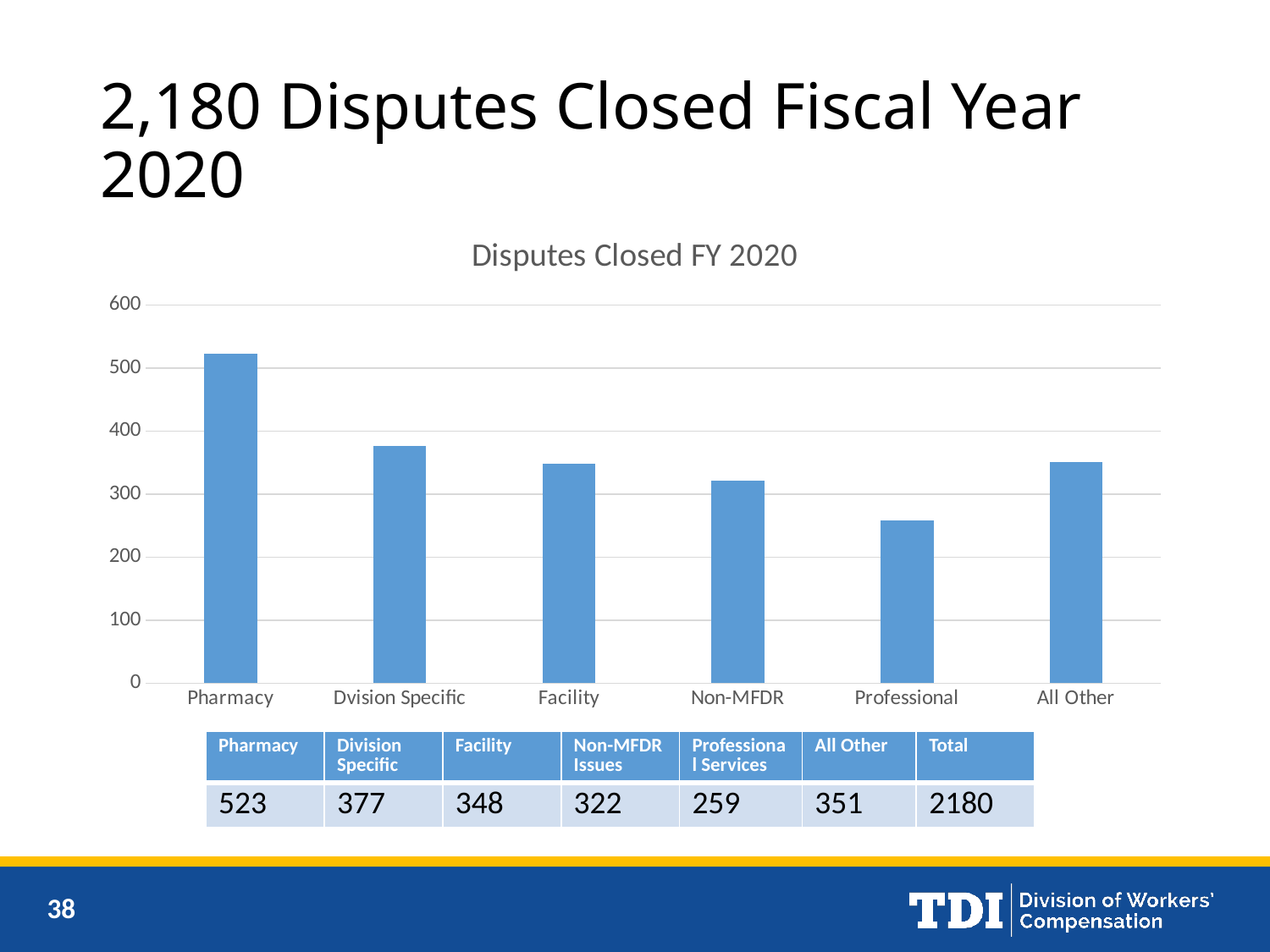
Which category has the highest value? Pharmacy What is the total of all disputes closed shown in the table? 2180 Which category has the lowest value? Professional Is the value for Facility greater or less than 300? greater What is the difference between the values for Pharmacy and Division Specific? 146 What is the value for Non-MFDR? 322 How many categories are plotted in the chart? 6 What is the title of the chart? Disputes Closed FY 2020 What type of chart is shown on the slide? bar chart Which is larger, the value for Division Specific or the value for Non-MFDR? Division Specific What is the value for Professional? 259 What is the value for Pharmacy? 523